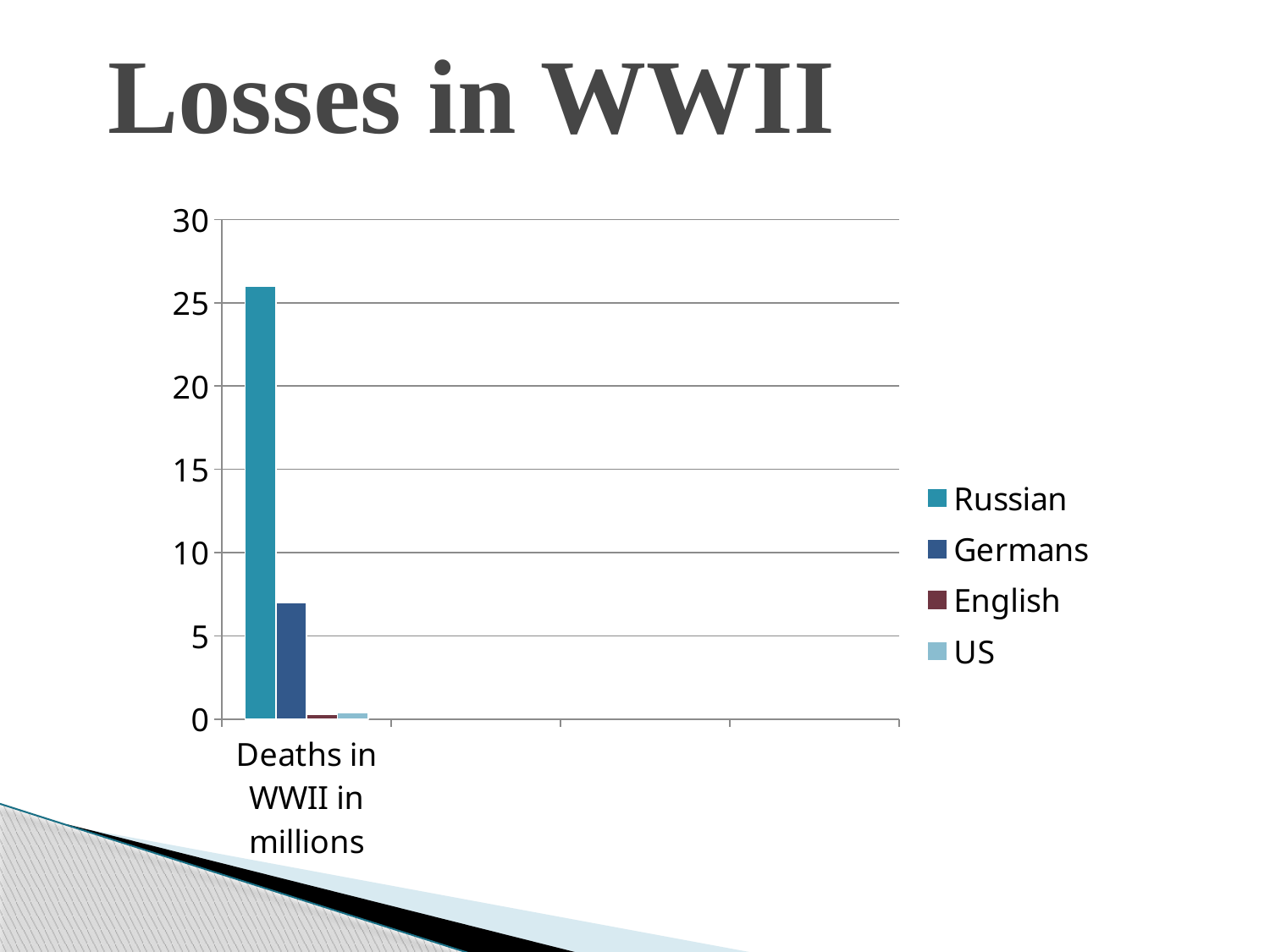
How many series does the legend list? 4 What is the label of the category on the x axis? Deaths in WWII in millions Is the value for Germans greater or less than 5? greater Which is larger, the value for Germans or the value for English? Germans What kind of chart is shown on the slide? bar chart What is the title of the slide? Losses in WWII Is the value for Russian greater or less than 20? greater How many categories are shown on the x axis? 1 Which series has the highest value for Deaths in WWII in millions? Russian Is the value for Germans greater or less than 10? less Which is larger, the value for Russian or the value for Germans? Russian